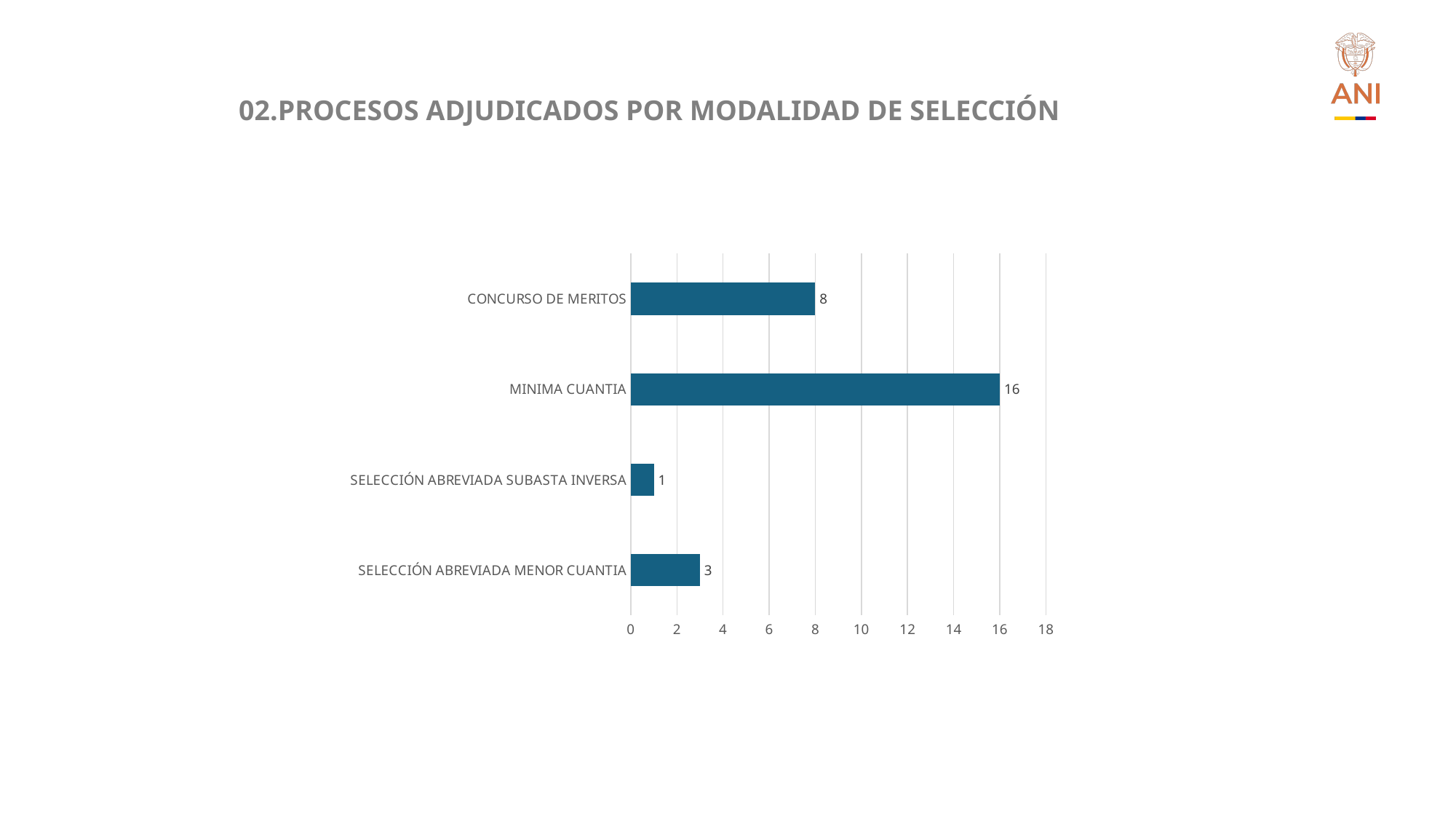
What is the value for SELECCIÓN ABREVIADA MENOR CUANTIA? 3 Which is larger, the value for SELECCIÓN ABREVIADA MENOR CUANTIA or SELECCIÓN ABREVIADA SUBASTA INVERSA? SELECCIÓN ABREVIADA MENOR CUANTIA How many categories are shown in the chart? 4 Which category has the highest value? MINIMA CUANTIA What kind of chart is shown on the slide? bar chart What is the difference between the values for MINIMA CUANTIA and CONCURSO DE MERITOS? 8 Is the value for MINIMA CUANTIA greater or less than 10? greater What is the value for MINIMA CUANTIA? 16 What is the value for CONCURSO DE MERITOS? 8 Which category has the lowest value? SELECCIÓN ABREVIADA SUBASTA INVERSA What is the value for SELECCIÓN ABREVIADA SUBASTA INVERSA? 1 What is the title of the slide? 02.PROCESOS ADJUDICADOS POR MODALIDAD DE SELECCIÓN